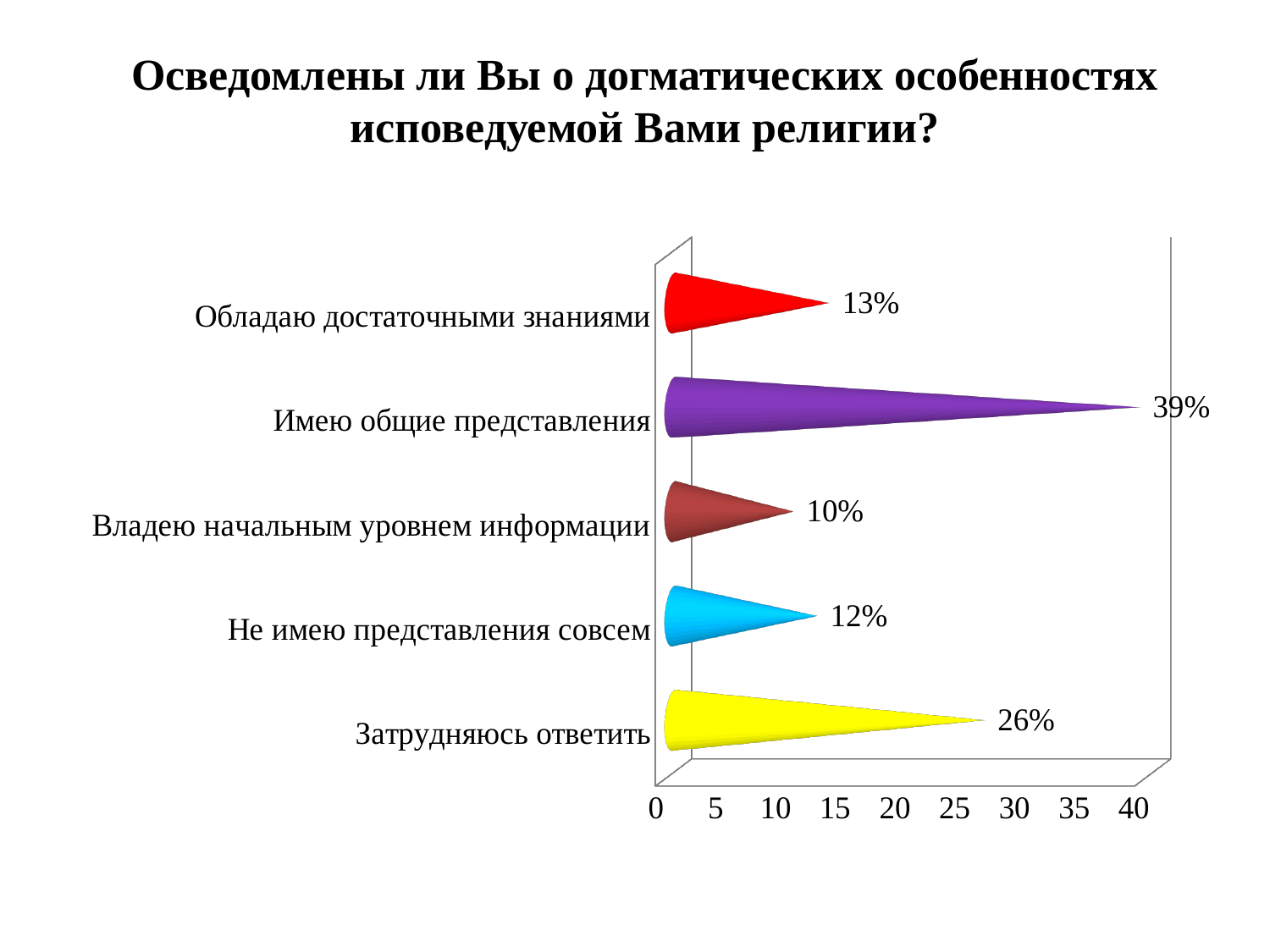
Which is larger: the value for "Не имею представления совсем" or the value for "Затрудняюсь ответить"? Затрудняюсь ответить What kind of chart is shown on the slide? bar chart How many categories are shown in the chart? 5 Which category has the highest value? Имею общие представления Which category has the lowest value? Владею начальным уровнем информации What colour is the bar for "Затрудняюсь ответить"? yellow What is the value for "Затрудняюсь ответить"? 26% What is the difference between the values for "Имею общие представления" and "Затрудняюсь ответить"? 13% What is the value for "Обладаю достаточными знаниями"? 13% Is the value for "Имею общие представления" greater or less than 30? greater What is the value for "Владею начальным уровнем информации"? 10% What is the value for "Имею общие представления"? 39%